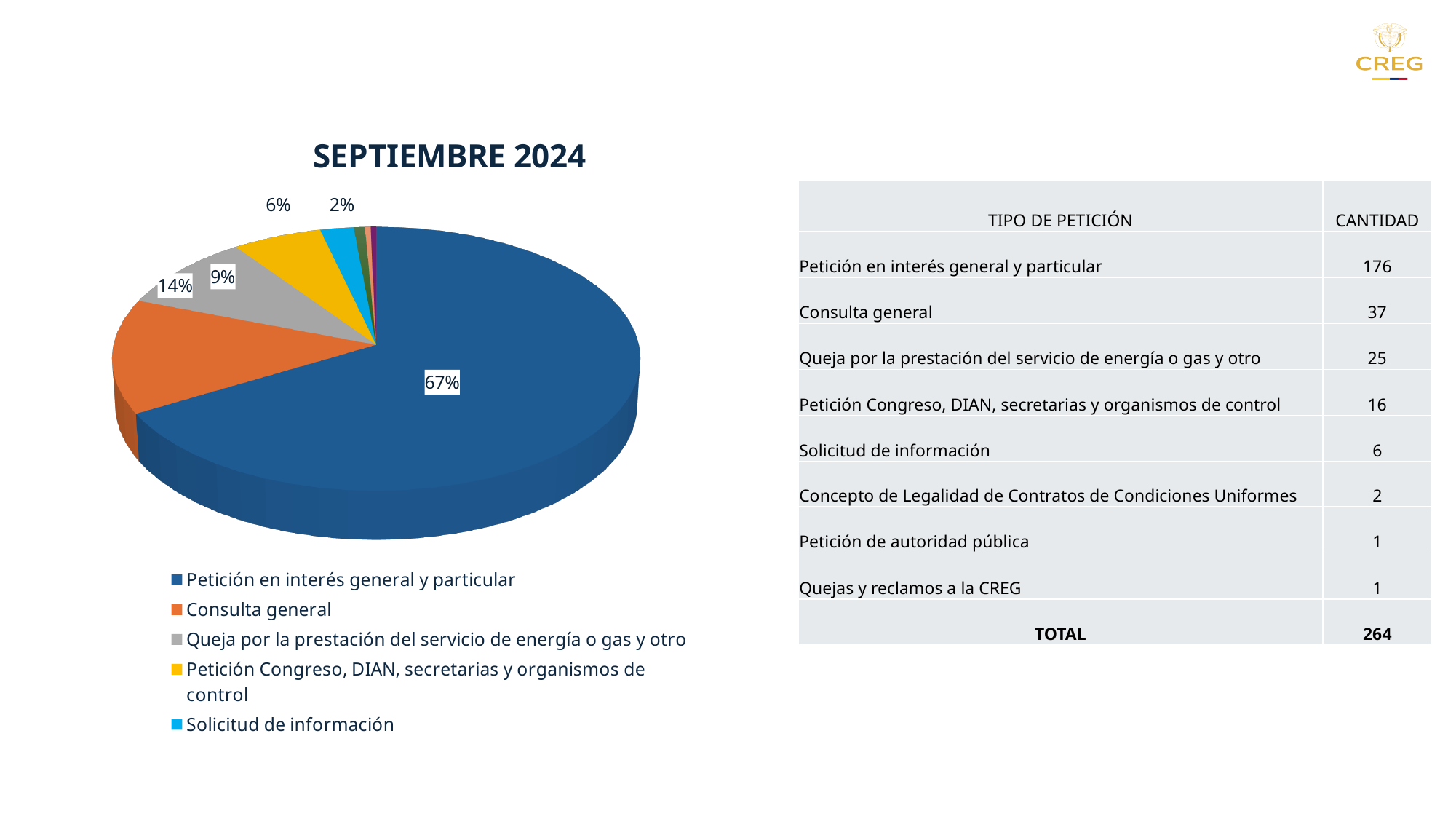
What percentage does the pie chart show for Consulta general? 14% How many entries does the chart legend list? 5 What colour is the slice for Consulta general in the pie chart? Orange What is the title of the chart? SEPTIEMBRE 2024 What type of chart is shown on the slide? Pie chart What is the difference in percentage points between Petición en interés general y particular and Consulta general in the pie chart? 53 What percentage does the pie chart show for Solicitud de información? 2% What percentage does the pie chart show for Petición en interés general y particular? 67% Which category has the largest slice of the pie chart? Petición en interés general y particular Which is larger in the pie chart: Consulta general or Queja por la prestación del servicio de energía o gas y otro? Consulta general What percentage does the pie chart show for Petición Congreso, DIAN, secretarias y organismos de control? 6% What percentage does the pie chart show for Queja por la prestación del servicio de energía o gas y otro? 9%